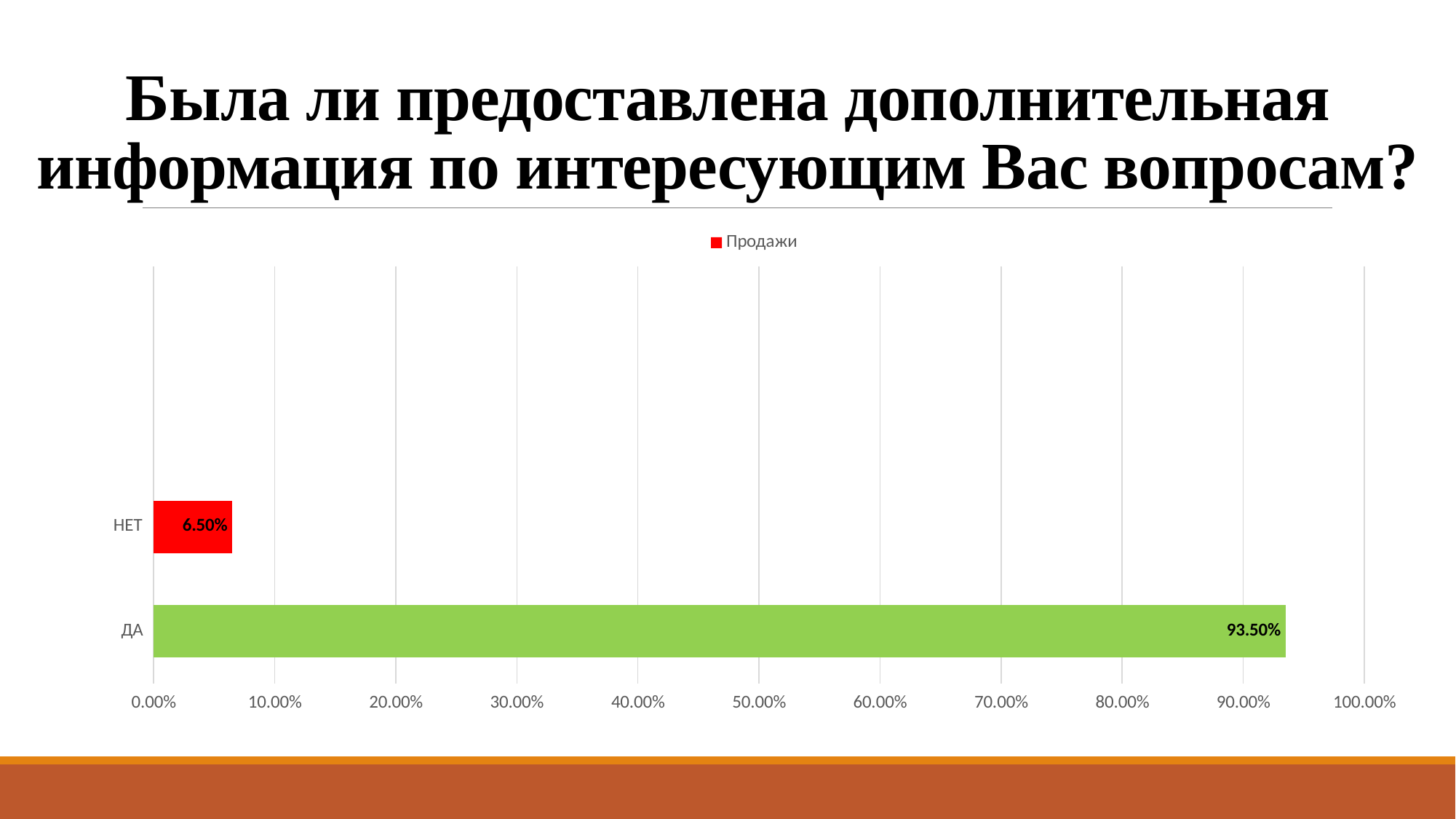
What kind of chart is shown on the slide? bar chart What is the value for НЕТ? 6.50% How many series does the legend list? 1 How many categories are shown in the chart? 2 What is the value for ДА? 93.50% Which category has the lowest value? НЕТ What is the name of the series shown in the legend? Продажи Which is larger, the value for ДА or the value for НЕТ? ДА What is the difference between the values for ДА and НЕТ? 87.00% Is the value for ДА greater or less than 90.00%? greater Which category has the highest value? ДА Is the value for НЕТ greater or less than 10.00%? less